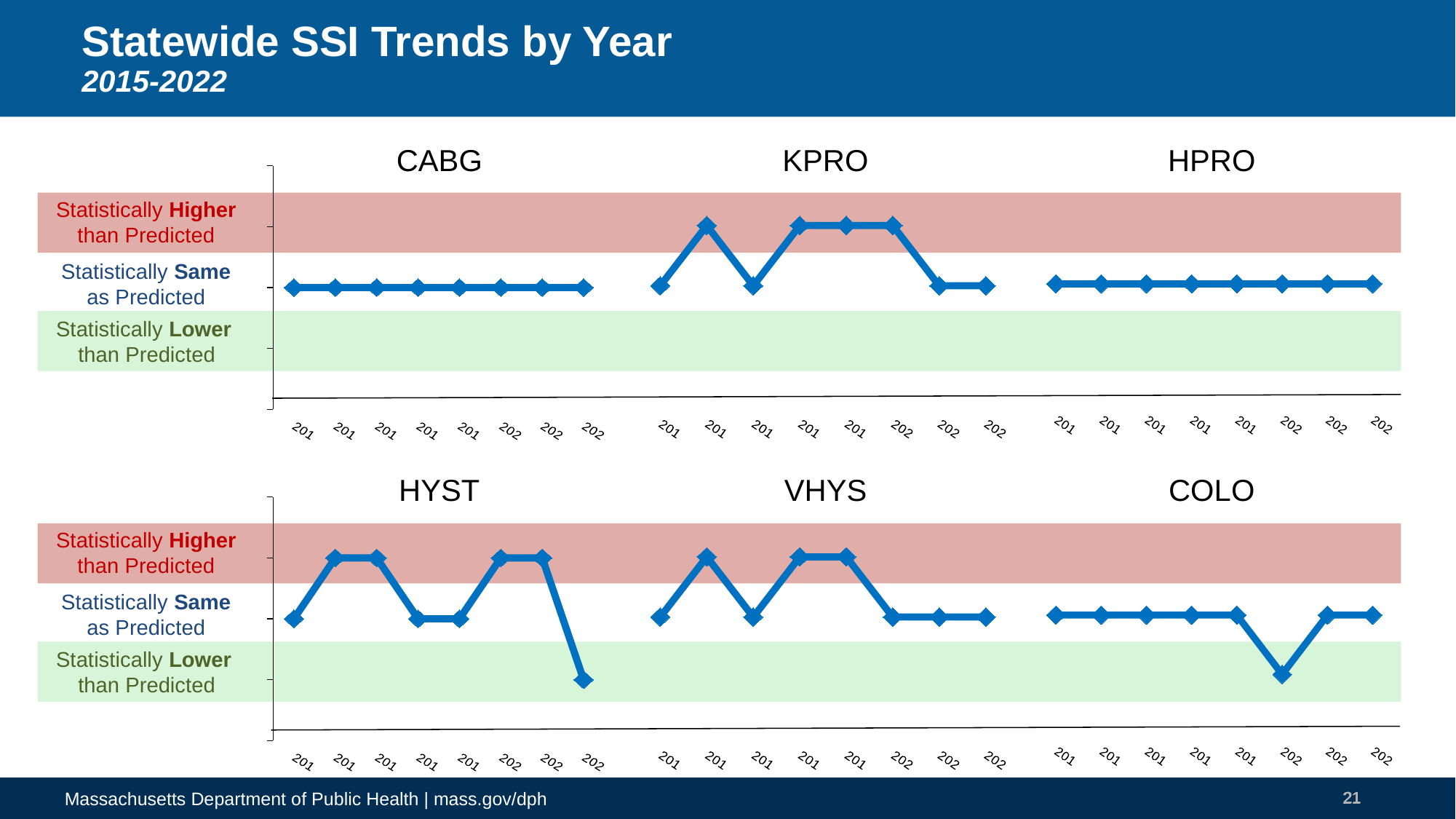
In the COLO chart, how many points fall in the Statistically Lower than Predicted band? 1 In the KPRO chart, how many points fall in the Statistically Higher than Predicted band? 4 How many data points are plotted in the CABG chart? 8 How many separate charts are shown on the slide? 6 What colour is the Statistically Higher than Predicted band shaded? red What kind of chart is used for the CABG panel? line chart In the CABG chart, which band do all the points fall in? Statistically Same as Predicted In the CABG chart, do the values rise, fall, or stay flat across the x axis? stay flat In the HYST chart, which band does the last point fall in? Statistically Lower than Predicted In the HPRO chart, which band do all the points fall in? Statistically Same as Predicted